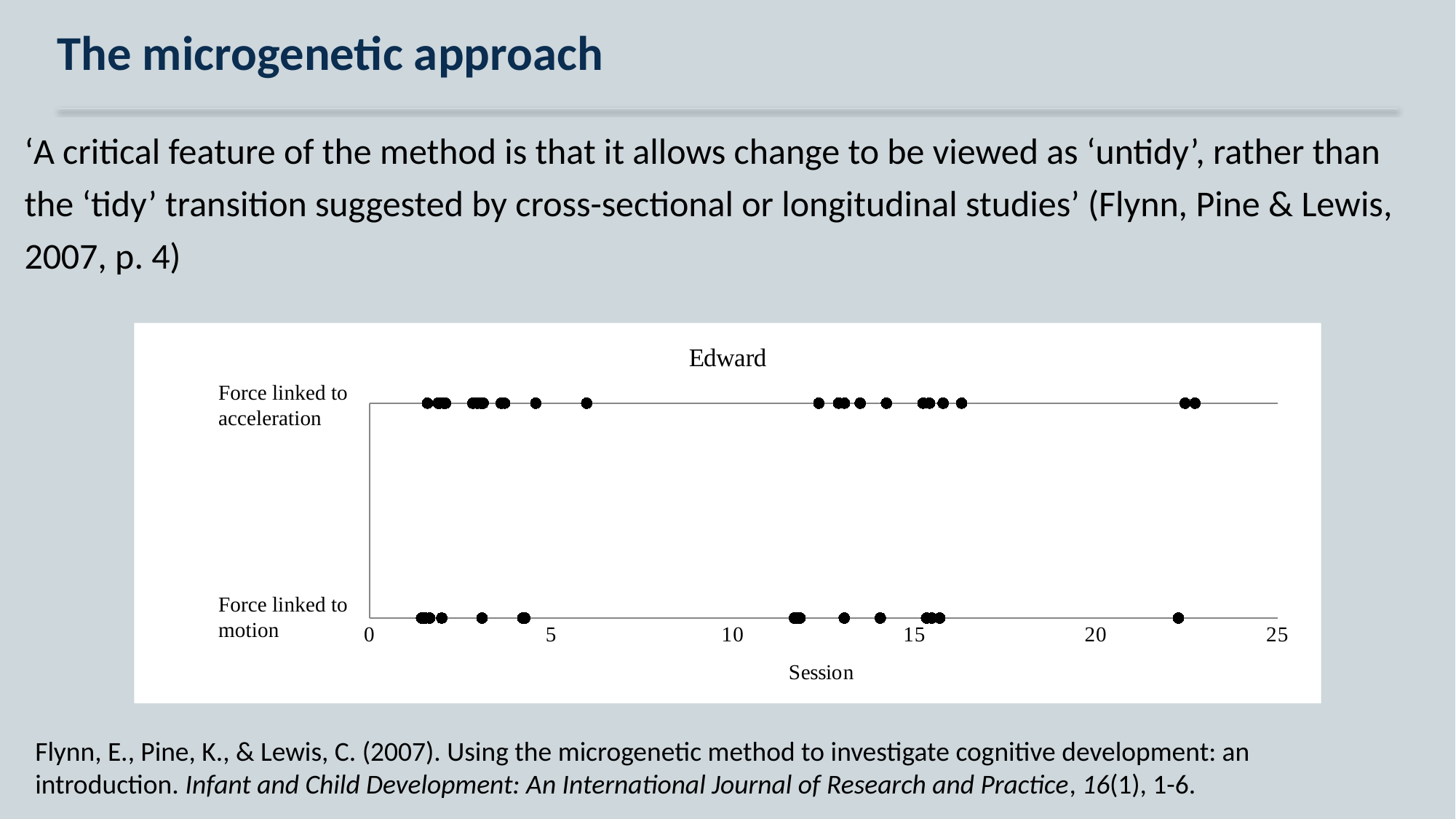
What is the lowest value shown on the x axis of the chart? 0 What is the highest value shown on the x axis of the chart? 25 Is the rightmost point in the 'Force linked to acceleration' row at a session greater or less than 25? less Is the rightmost point in the 'Force linked to motion' row at a session greater or less than 20? greater Is the leftmost point in the 'Force linked to acceleration' row at a session greater or less than 5? less What kind of chart is shown on the slide? scatter plot What is the title of the chart? Edward What is the label of the x axis of the chart? Session How many categories are plotted on the y axis of the chart? 2 Which category has a data point between session 5 and session 10? Force linked to acceleration Which category has a data point at around session 6? Force linked to acceleration How many data points lie between session 7 and session 11 on the chart? 0